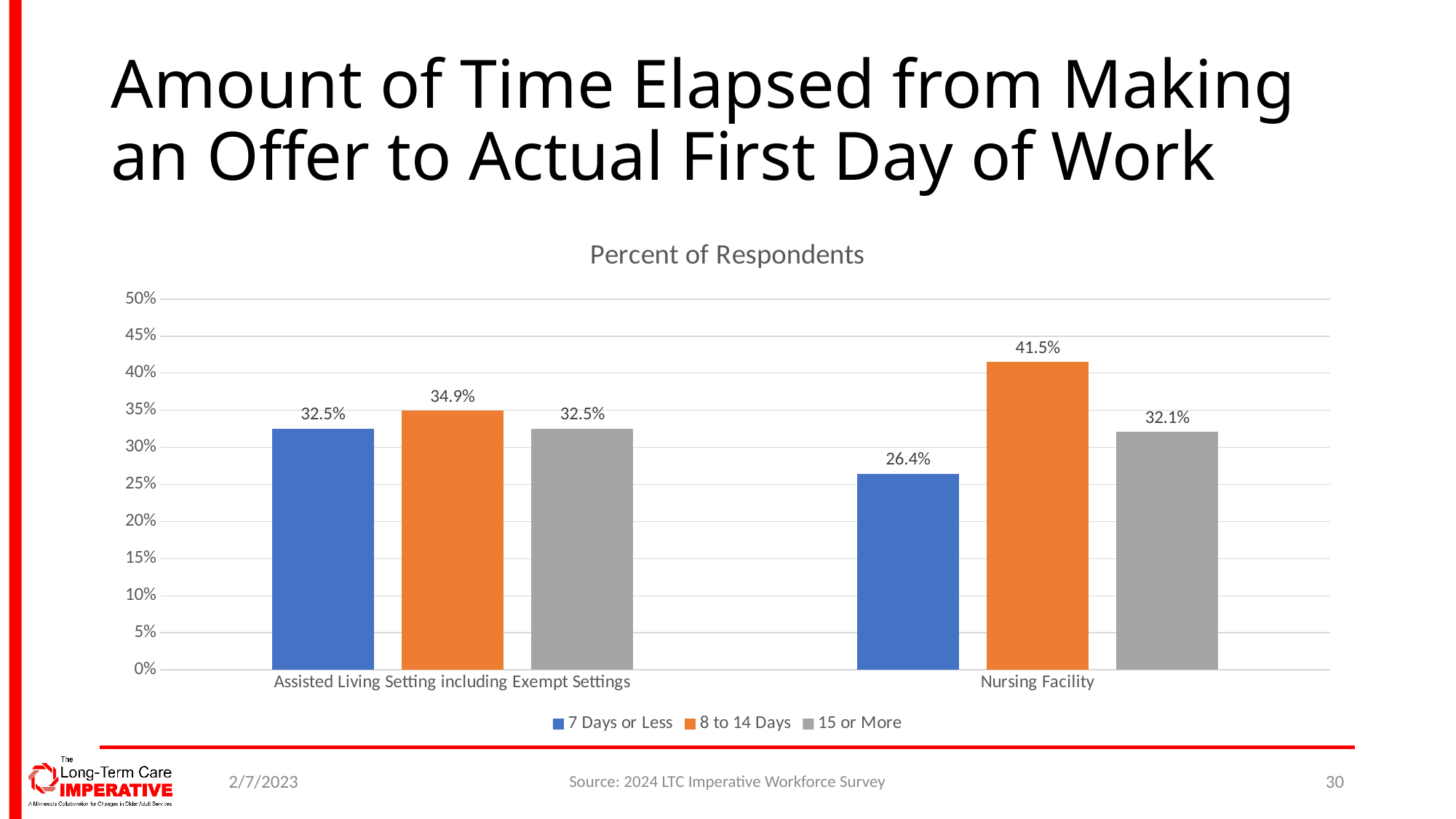
Which series has the highest value in the Nursing Facility category? 8 to 14 Days Is the 8 to 14 Days value for Nursing Facility greater or less than 40%? greater What is the value for 7 Days or Less in the Assisted Living Setting including Exempt Settings category? 32.5% What is the title of the chart? Percent of Respondents How many categories are shown on the x axis? 2 Which is larger: the 7 Days or Less value for Assisted Living Setting including Exempt Settings or for Nursing Facility? Assisted Living Setting including Exempt Settings What kind of chart is shown on the slide? Bar chart What percent of respondents in the Nursing Facility category reported 8 to 14 Days? 41.5% Which series has the lowest value in the Nursing Facility category? 7 Days or Less What is the difference between the 8 to 14 Days values for Nursing Facility and Assisted Living Setting including Exempt Settings? 6.6% How many series does the legend list? 3 What is the value for 15 or More in the Nursing Facility category? 32.1%